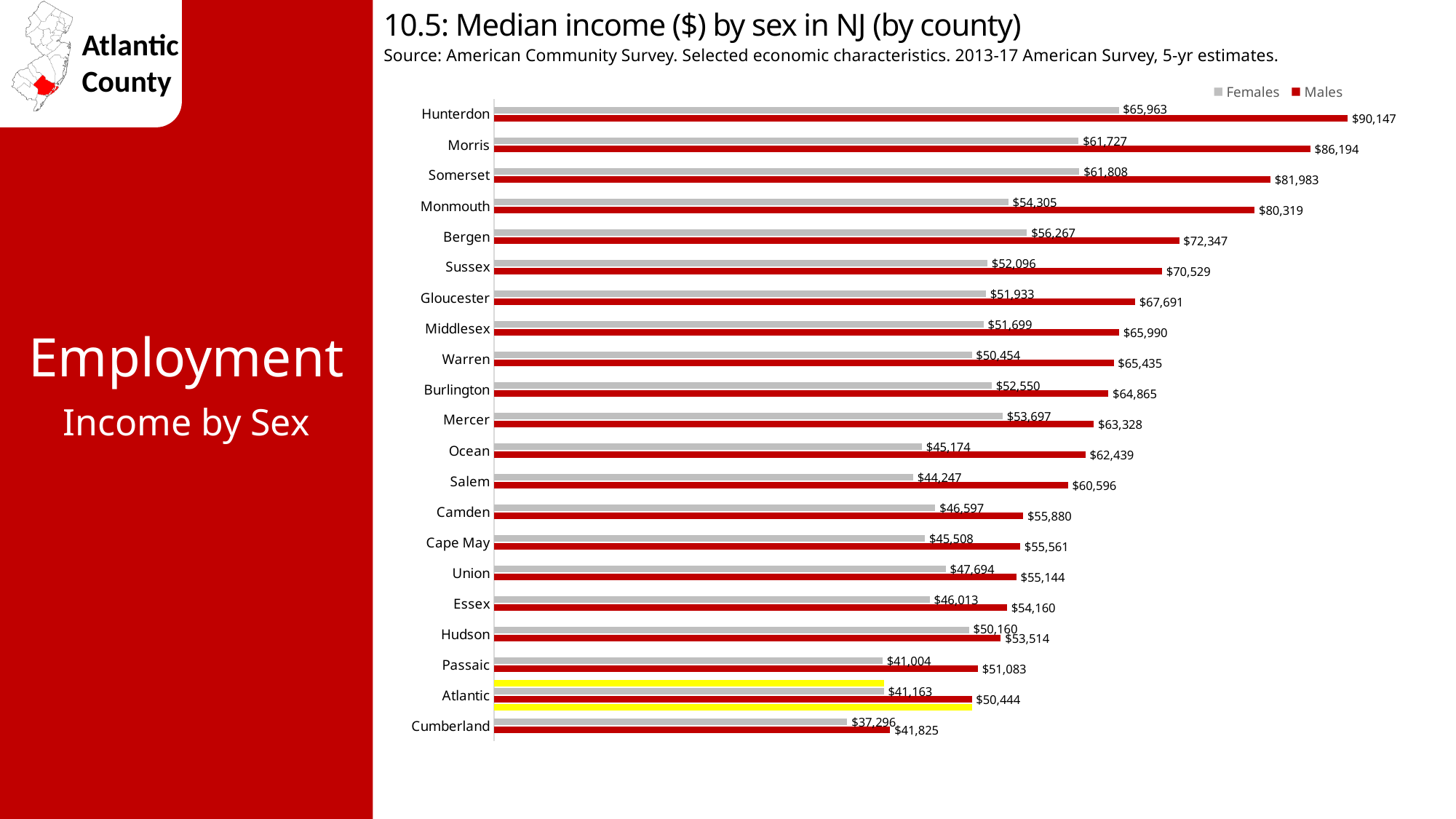
What kind of chart is shown on the slide? Bar chart Which county has the highest median income for males? Hunterdon What is the difference between male and female median income in Atlantic County? $9,281 How many counties are shown on the chart? 21 Which county has the lowest median income for females? Cumberland What is the median income for females in Hunterdon County? $65,963 Which is larger: the female median income in Bergen County or in Monmouth County? Bergen What is the median income for males in Atlantic County? $50,444 What is the median income for males in Bergen County? $72,347 What is the difference between male and female median income in Hunterdon County? $24,184 How many series does the legend list? 2 What is the median income for females in Cumberland County? $37,296